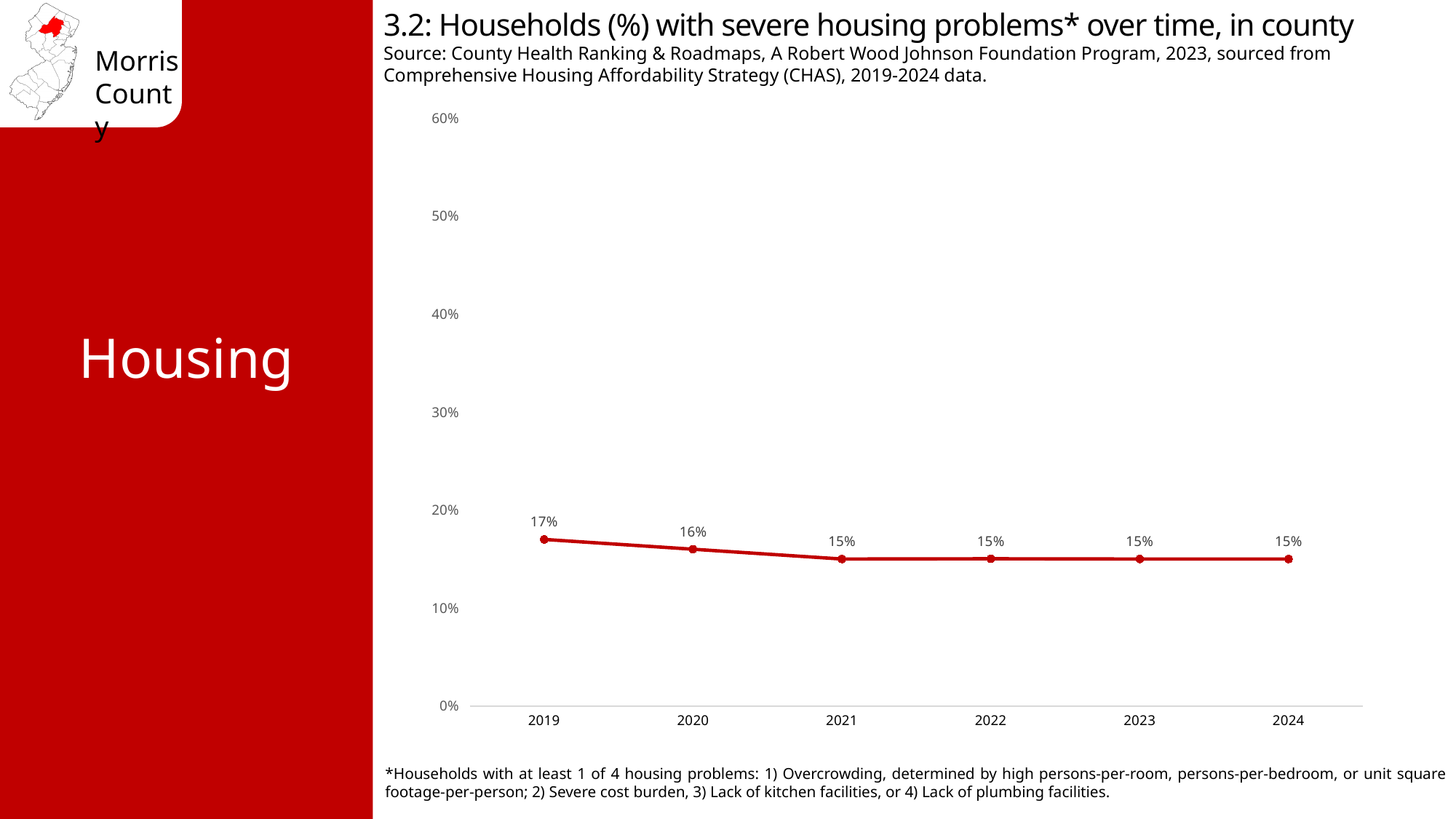
Do the values rise or fall from 2019 to 2021? fall What percentage of households had severe housing problems in 2019? 17% What is the highest value shown on the vertical axis? 60% What is the value shown for 2020? 16% What is the title of the chart? 3.2: Households (%) with severe housing problems* over time, in county Is the value for 2022 greater or less than 20%? less Which year has the highest percentage of households with severe housing problems? 2019 What percentage of households had severe housing problems in 2024? 15% What kind of chart is shown on the slide? line chart Which is larger, the value for 2019 or the value for 2020? 2019 What is the difference in percentage points between 2019 and 2021? 2 How many years are plotted on the chart? 6